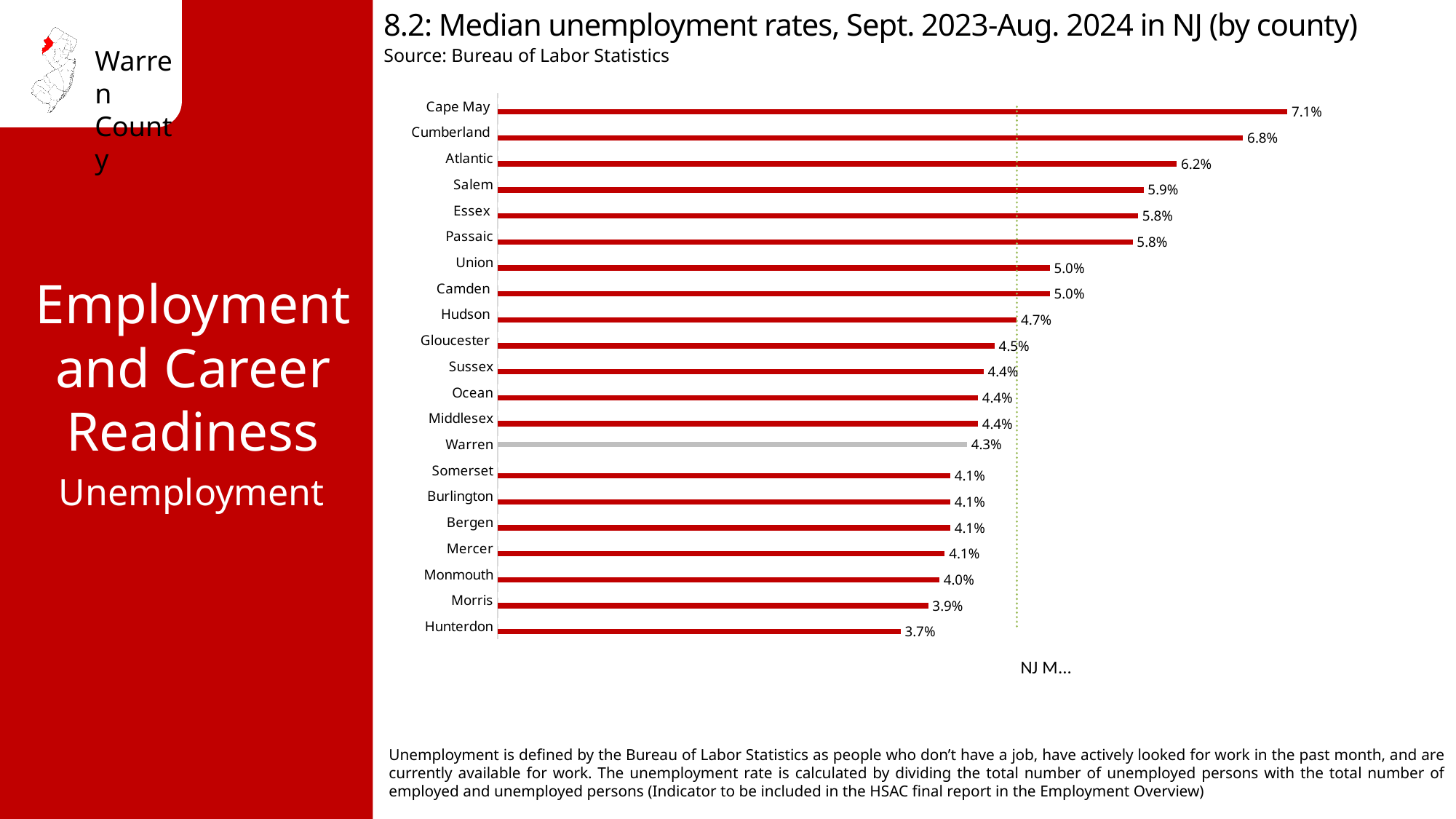
What is the difference between the median unemployment rates of Cape May and Hunterdon? 3.4% What is the median unemployment rate for Warren? 4.3% How many counties are shown in the chart? 21 Which has a higher median unemployment rate, Atlantic or Salem? Atlantic Which county has the lowest median unemployment rate? Hunterdon Which county has the highest median unemployment rate? Cape May Which has a higher median unemployment rate, Morris or Monmouth? Monmouth What kind of chart is shown on the slide? Bar chart What is the median unemployment rate for Cape May? 7.1% What is the difference between the median unemployment rates of Cumberland and Warren? 2.5% Which county's bar is shown in grey rather than red? Warren What is the median unemployment rate for Hudson? 4.7%